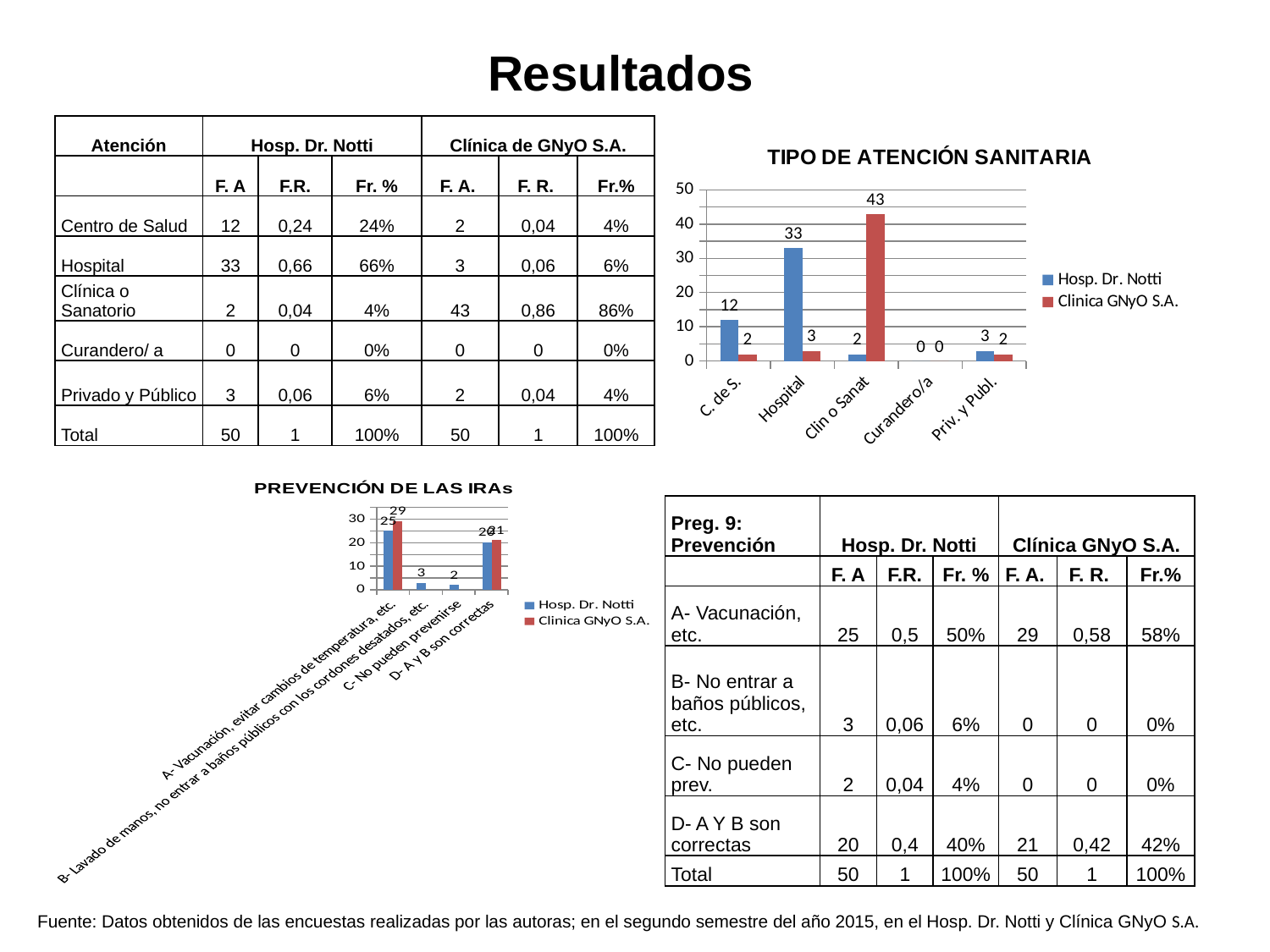
In the chart titled TIPO DE ATENCIÓN SANITARIA, what is the value for Clin o Sanat in the Clinica GNyO S.A. series? 43 In the chart titled TIPO DE ATENCIÓN SANITARIA, which series has the larger value for Hospital, Hosp. Dr. Notti or Clinica GNyO S.A.? Hosp. Dr. Notti In the chart titled TIPO DE ATENCIÓN SANITARIA, what is the difference between the Clinica GNyO S.A. value and the Hosp. Dr. Notti value for Clin o Sanat? 41 In the chart titled TIPO DE ATENCIÓN SANITARIA, what is the value for Hospital in the Hosp. Dr. Notti series? 33 In the chart titled TIPO DE ATENCIÓN SANITARIA, what is the value for C. de S. in the Hosp. Dr. Notti series? 12 How many categories are shown on the x axis of the chart titled TIPO DE ATENCIÓN SANITARIA? 5 In the chart titled PREVENCIÓN DE LAS IRAs, what is the value for the Clinica GNyO S.A. series in the category A- Vacunación, evitar cambios de temperatura, etc.? 29 In the chart titled PREVENCIÓN DE LAS IRAs, which series has the larger value for the category A- Vacunación, evitar cambios de temperatura, etc., Hosp. Dr. Notti or Clinica GNyO S.A.? Clinica GNyO S.A. How many series does the legend of the chart titled TIPO DE ATENCIÓN SANITARIA list? 2 In the chart titled TIPO DE ATENCIÓN SANITARIA, which category has the highest value in the Clinica GNyO S.A. series? Clin o Sanat What kind of chart is the chart titled PREVENCIÓN DE LAS IRAs? Bar chart In the chart titled TIPO DE ATENCIÓN SANITARIA, which category has the highest value in the Hosp. Dr. Notti series? Hospital